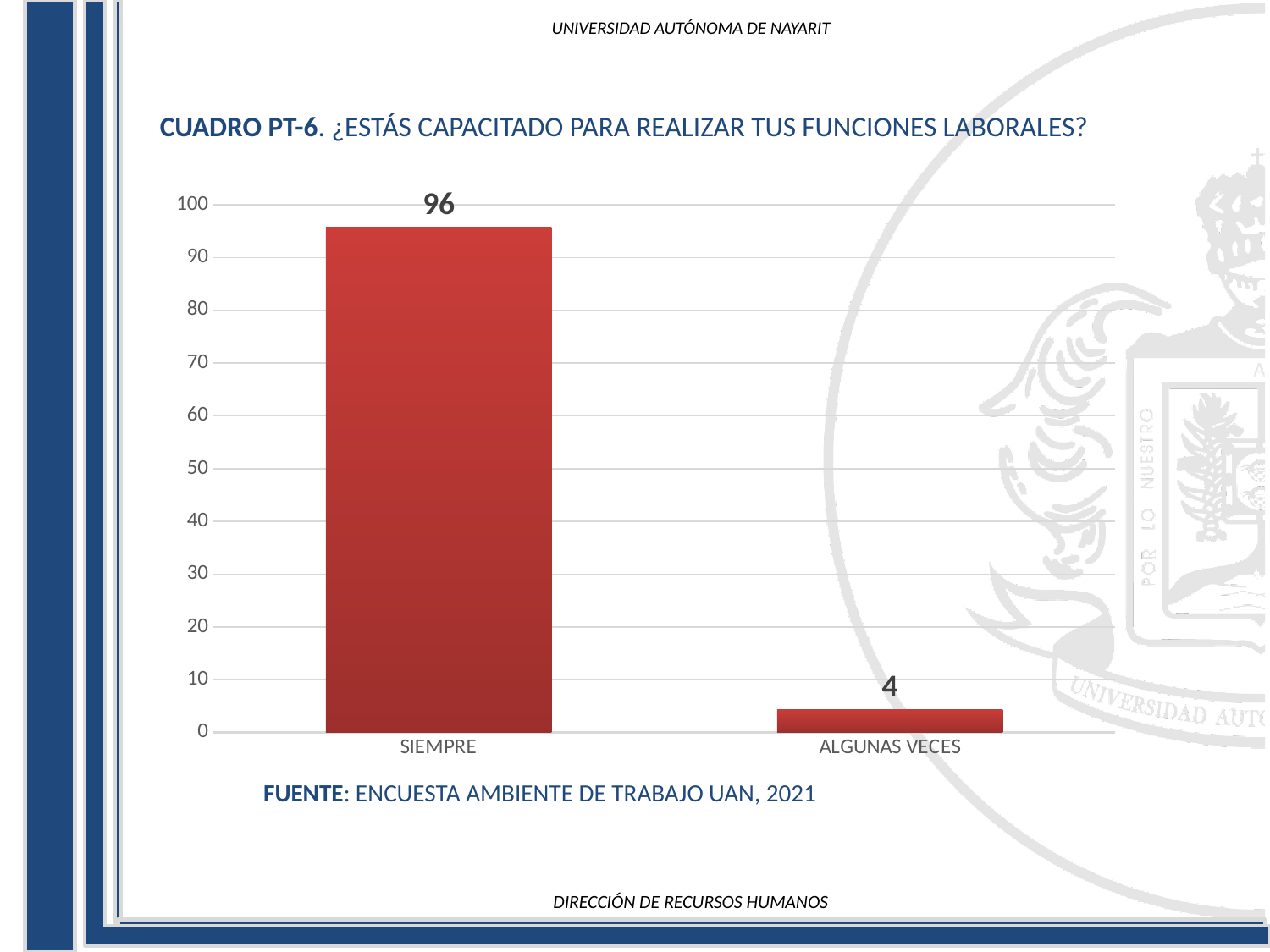
What is the value for ALGUNAS VECES? 4 Is the value for SIEMPRE greater or less than 90? greater What is the total of the two values shown in the chart? 100 What source is cited below the chart? ENCUESTA AMBIENTE DE TRABAJO UAN, 2021 What is the difference between the values for SIEMPRE and ALGUNAS VECES? 92 What is the value for SIEMPRE? 96 What kind of chart is shown on the slide? bar chart How many categories are shown on the x axis? 2 Is the value for ALGUNAS VECES greater or less than 10? less Which category has the highest value? SIEMPRE Which is larger, the value for SIEMPRE or the value for ALGUNAS VECES? SIEMPRE Which category has the lowest value? ALGUNAS VECES